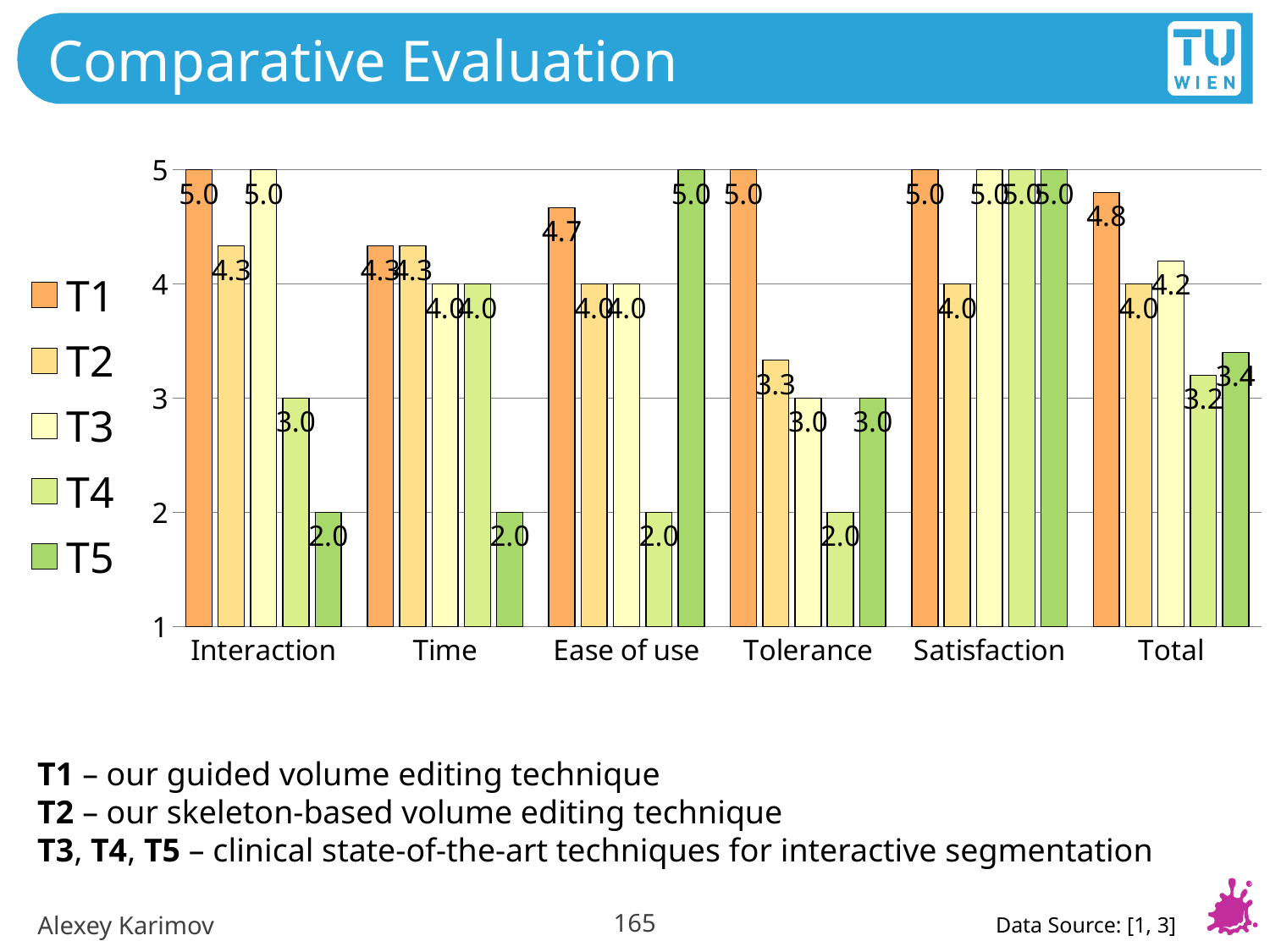
What kind of chart is shown on the slide? Bar chart What is the value for T1 in the Ease of use category? 4.7 How many categories are shown on the x axis? 6 What is the value for T2 in the Tolerance category? 3.3 Which series has the highest value in the Ease of use category? T5 What is the difference between the T1 and T5 values in the Interaction category? 3.0 Which series has the lowest value in the Total category? T4 In the Tolerance category, which is larger: the value for T1 or the value for T2? T1 How many series does the legend list? 5 What is the title of the slide containing the chart? Comparative Evaluation What is the value for T1 in the Total category? 4.8 What is the value for T4 in the Interaction category? 3.0